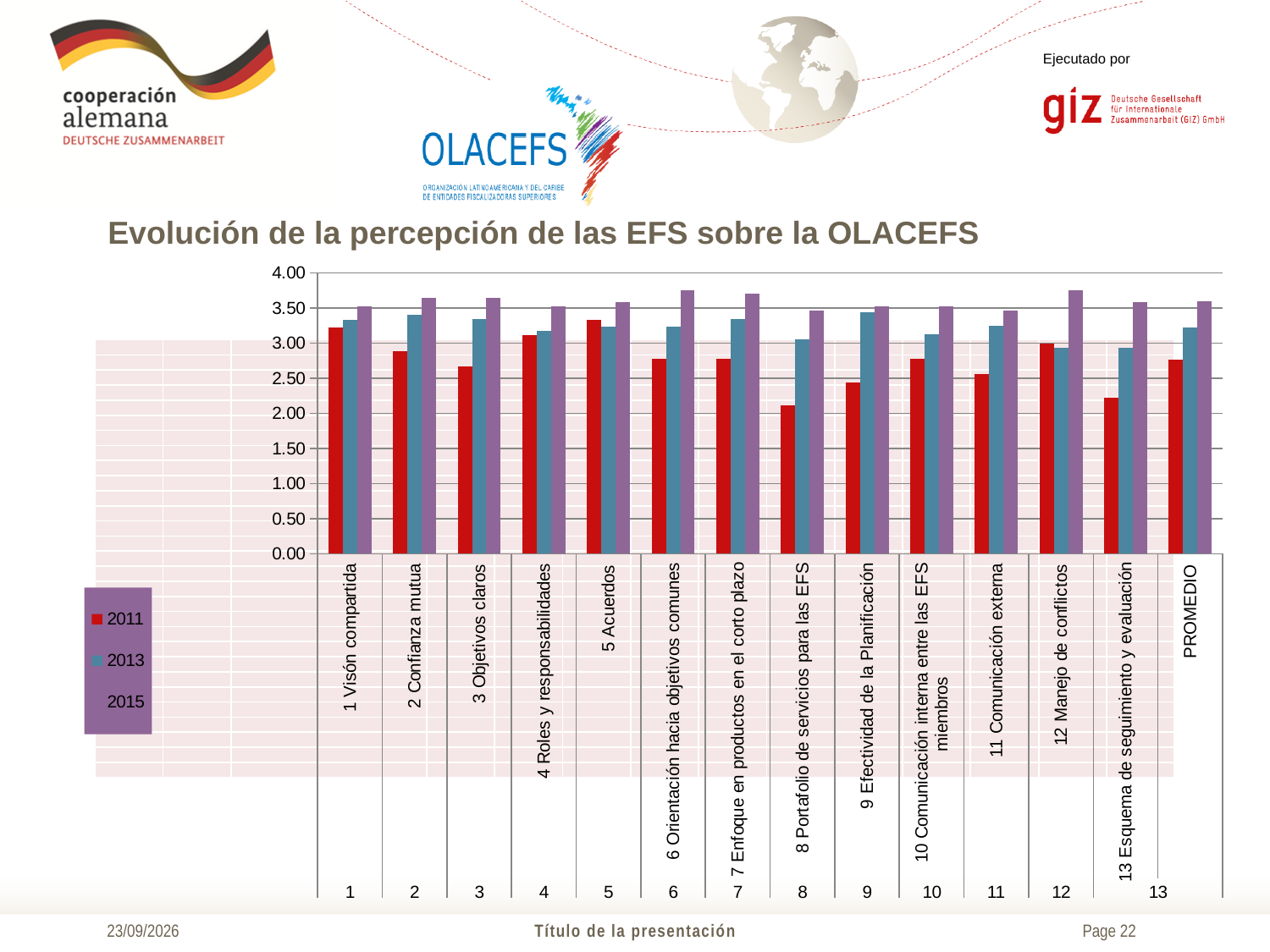
Is the 2011 value for '3 Objetivos claros' greater or less than 3.00? less For '8 Portafolio de servicios para las EFS', which is larger: the 2011 value or the 2015 value? 2015 How many series does the legend list? 3 For PROMEDIO, do the values rise or fall from 2011 to 2015? rise Is the 2015 value for '6 Orientación hacia objetivos comunes' greater or less than 3.50? greater What kind of chart is shown on the slide? bar chart Which years are listed in the legend? 2011, 2013, 2015 How many categories are shown along the x axis, including PROMEDIO? 14 Is the 2011 value for '5 Acuerdos' greater or less than 3.00? greater What is the title of the chart? Evolución de la percepción de las EFS sobre la OLACEFS